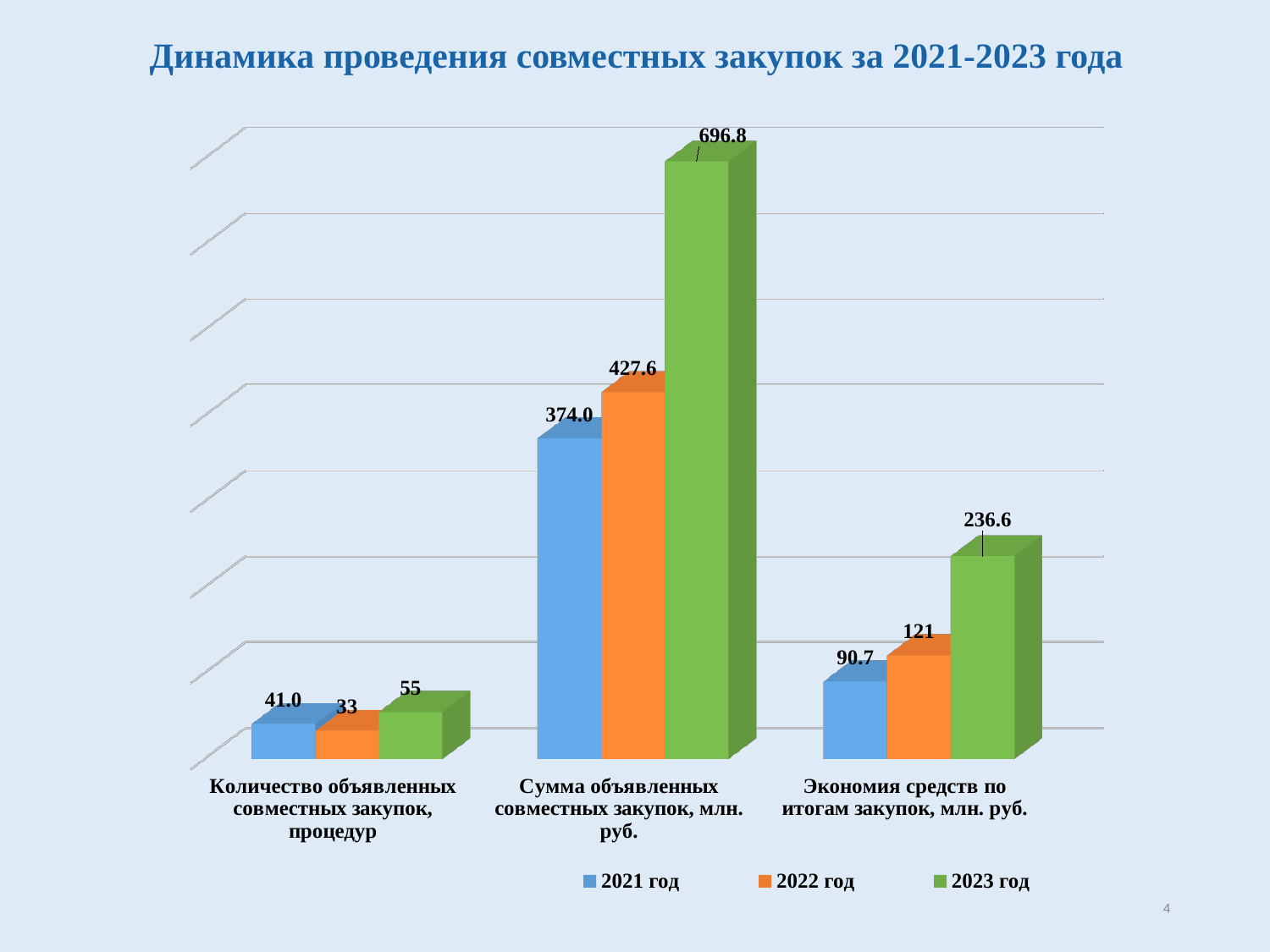
What is the value for 2023 год in the category 'Сумма объявленных совместных закупок, млн. руб.'? 696.8 What is the difference between the 2022 год and 2021 год values in the category 'Экономия средств по итогам закупок, млн. руб.'? 30.3 How many categories are shown on the x axis of the chart? 3 In the category 'Количество объявленных совместных закупок, процедур', which is larger: the value for 2021 год or for 2023 год? 2023 год How many series does the legend list? 3 Which year has the lowest value in the category 'Количество объявленных совместных закупок, процедур'? 2022 год What kind of chart is shown on the slide? Bar chart Which year has the highest value in the category 'Экономия средств по итогам закупок, млн. руб.'? 2023 год What is the difference between the 2023 год and 2022 год values in the category 'Сумма объявленных совместных закупок, млн. руб.'? 269.2 What is the title of the chart on the slide? Динамика проведения совместных закупок за 2021-2023 года What is the value for 2022 год in the category 'Экономия средств по итогам закупок, млн. руб.'? 121 What is the value for 2021 год in the category 'Количество объявленных совместных закупок, процедур'? 41.0